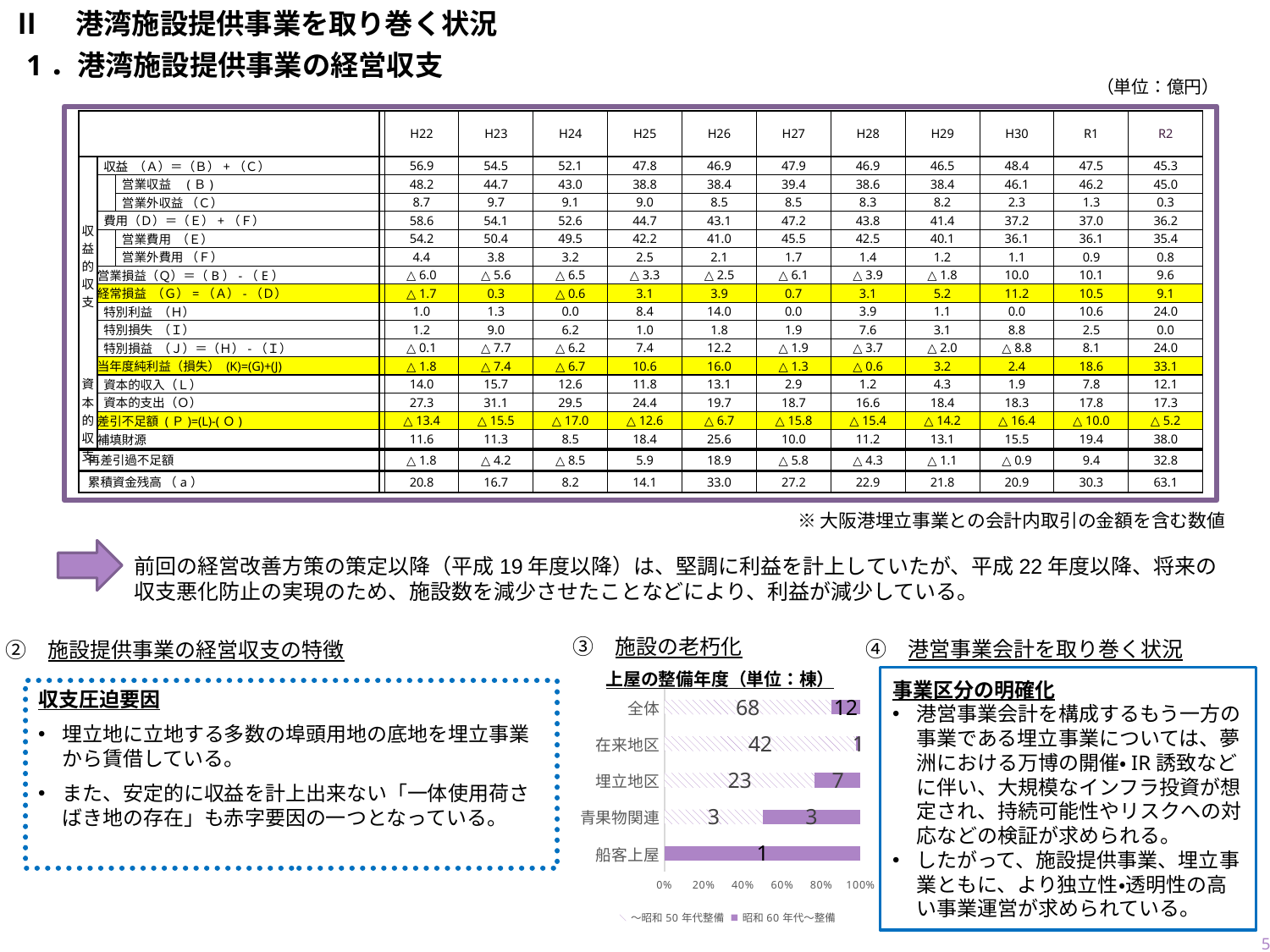
How many categories are shown in the chart 上屋の整備年度（単位：棟）? 5 In the chart 上屋の整備年度（単位：棟）, what is the value for 全体 in the ～昭和50年代整備 series? 68 In the chart 上屋の整備年度（単位：棟）, which category has the highest value in the ～昭和50年代整備 series? 全体 In the chart 上屋の整備年度（単位：棟）, what is the value for 埋立地区 in the 昭和60年代～整備 series? 7 In the chart 上屋の整備年度（単位：棟）, what is the value for 青果物関連 in the 昭和60年代～整備 series? 3 How many series does the legend of the chart 上屋の整備年度（単位：棟） list? 2 What kind of chart is 上屋の整備年度（単位：棟）? Bar chart In the chart 上屋の整備年度（単位：棟）, what is the total of the stacked bar for 埋立地区? 30 In the chart 上屋の整備年度（単位：棟）, for 埋立地区, which series has the larger value: ～昭和50年代整備 or 昭和60年代～整備? ～昭和50年代整備 In the chart 上屋の整備年度（単位：棟）, what is the total of the stacked bar for 在来地区? 43 In the chart 上屋の整備年度（単位：棟）, what is the difference between the ～昭和50年代整備 and 昭和60年代～整備 values for 全体? 56 In the chart 上屋の整備年度（単位：棟）, what is the value for 在来地区 in the 昭和60年代～整備 series? 1